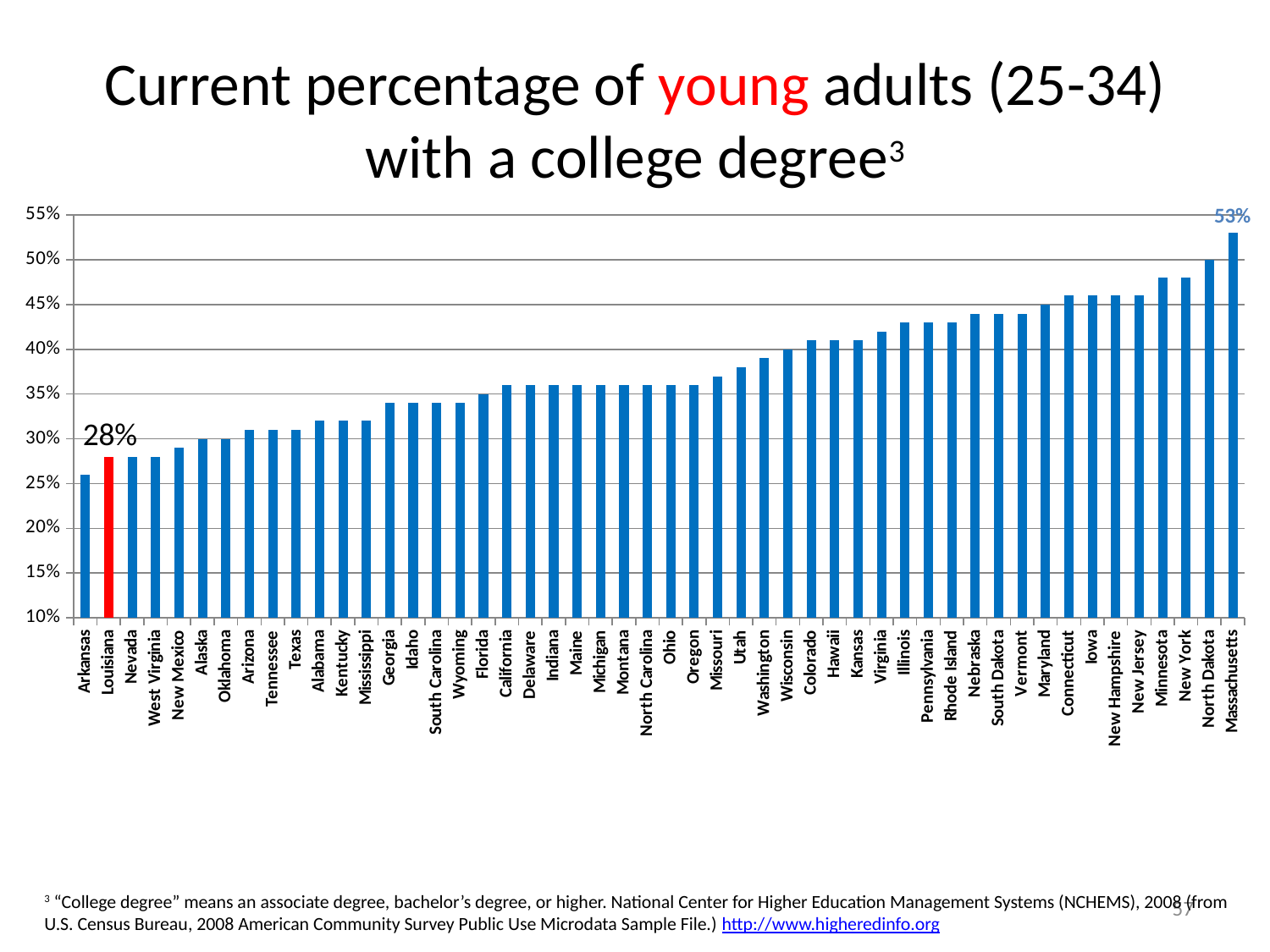
Is the value for Arkansas greater or less than 30%? less Which has a higher value, Texas or Colorado? Colorado Is the value for Georgia greater or less than 35%? less What is the value shown for Massachusetts? 53% Which state has the highest percentage of young adults with a college degree? Massachusetts Which state has the lowest percentage of young adults with a college degree? Arkansas How many states are shown on the chart? 50 What is the value shown for Louisiana? 28% Is the value for Minnesota greater or less than 45%? greater Do the values rise or fall from left to right across the chart? Rise What is the difference between the values for Massachusetts and Louisiana? 25 percentage points What kind of chart is shown on the slide? Bar chart